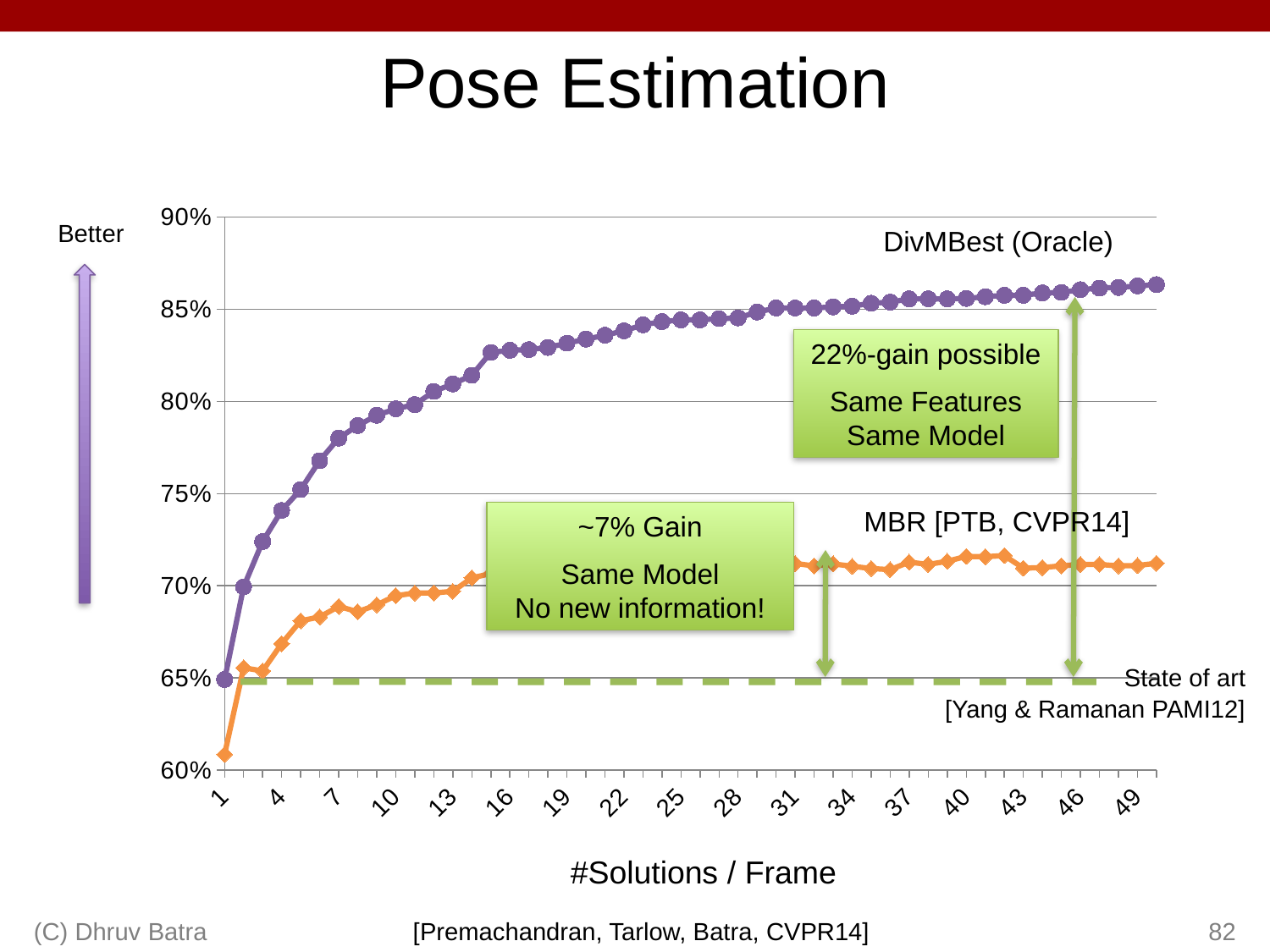
What is the label of the x axis? #Solutions / Frame What is the title of the slide's chart? Pose Estimation At what level is the dashed 'State of art' line drawn? 65% Does the DivMBest (Oracle) line rise or fall as the number of solutions per frame increases? rise Which line is higher at 49 solutions per frame, DivMBest (Oracle) or MBR [PTB, CVPR14]? DivMBest (Oracle) Is the value of MBR [PTB, CVPR14] at 49 solutions per frame greater or less than 70%? greater Is the value of DivMBest (Oracle) at 49 solutions per frame greater or less than 85%? greater Is the value of MBR [PTB, CVPR14] at 1 solution per frame greater or less than 65%? less What kind of chart is shown on the slide? line chart What is the highest value shown on the y axis? 90%